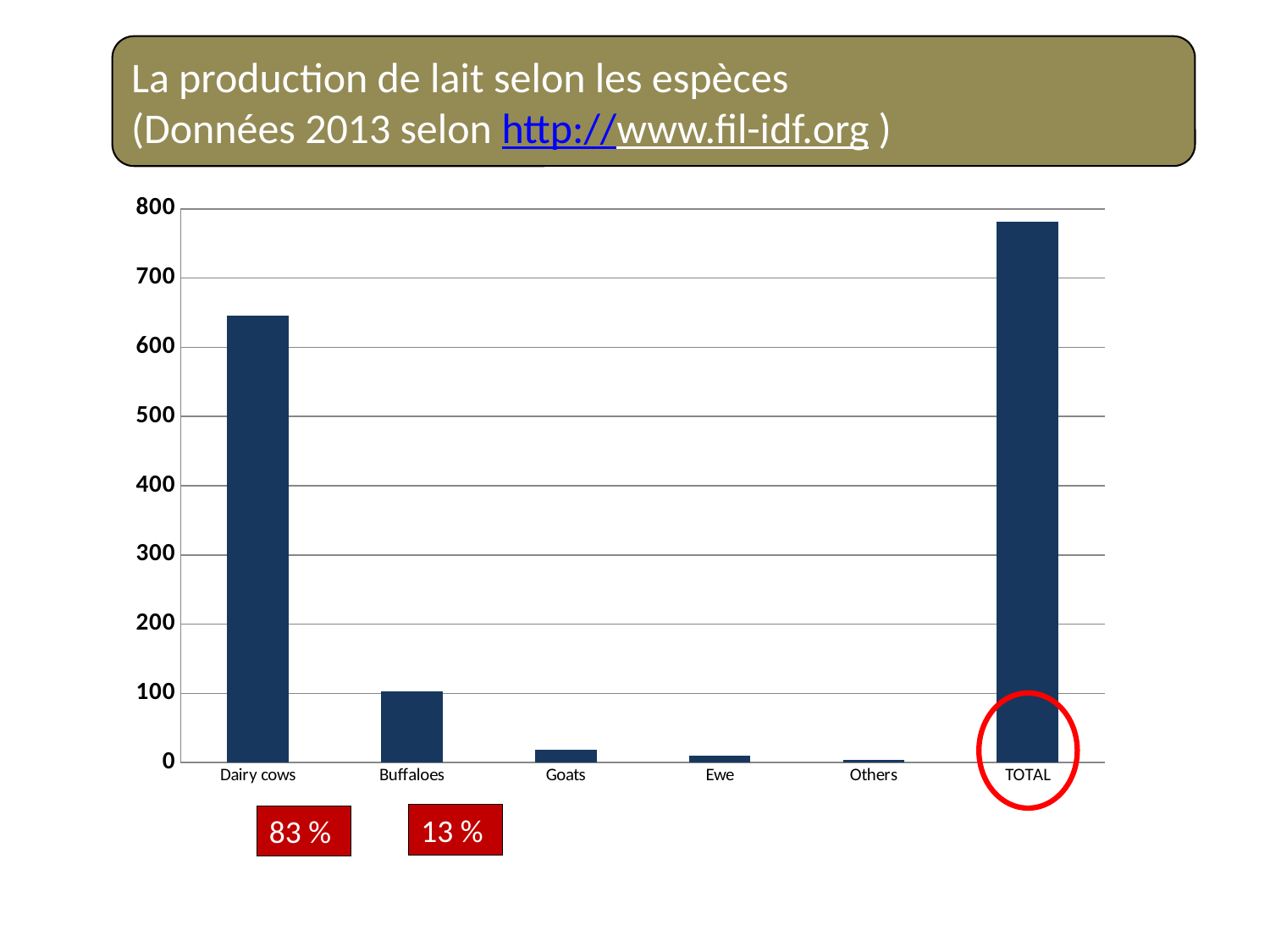
Is the value for Dairy cows greater or less than 600? greater Is the value for Buffaloes greater or less than 200? less Which bar is taller, Dairy cows or Buffaloes? Dairy cows Is the value for Goats greater or less than 100? less Which category has the tallest bar in the chart? TOTAL Which category has the shortest bar in the chart? Others Which bar is taller, Goats or Ewe? Goats What percentage is shown in the red box below the Dairy cows bar? 83 % Which category's bar is circled in red on the chart? TOTAL What kind of chart is shown on the slide? bar chart How many categories are shown on the x axis of the chart? 6